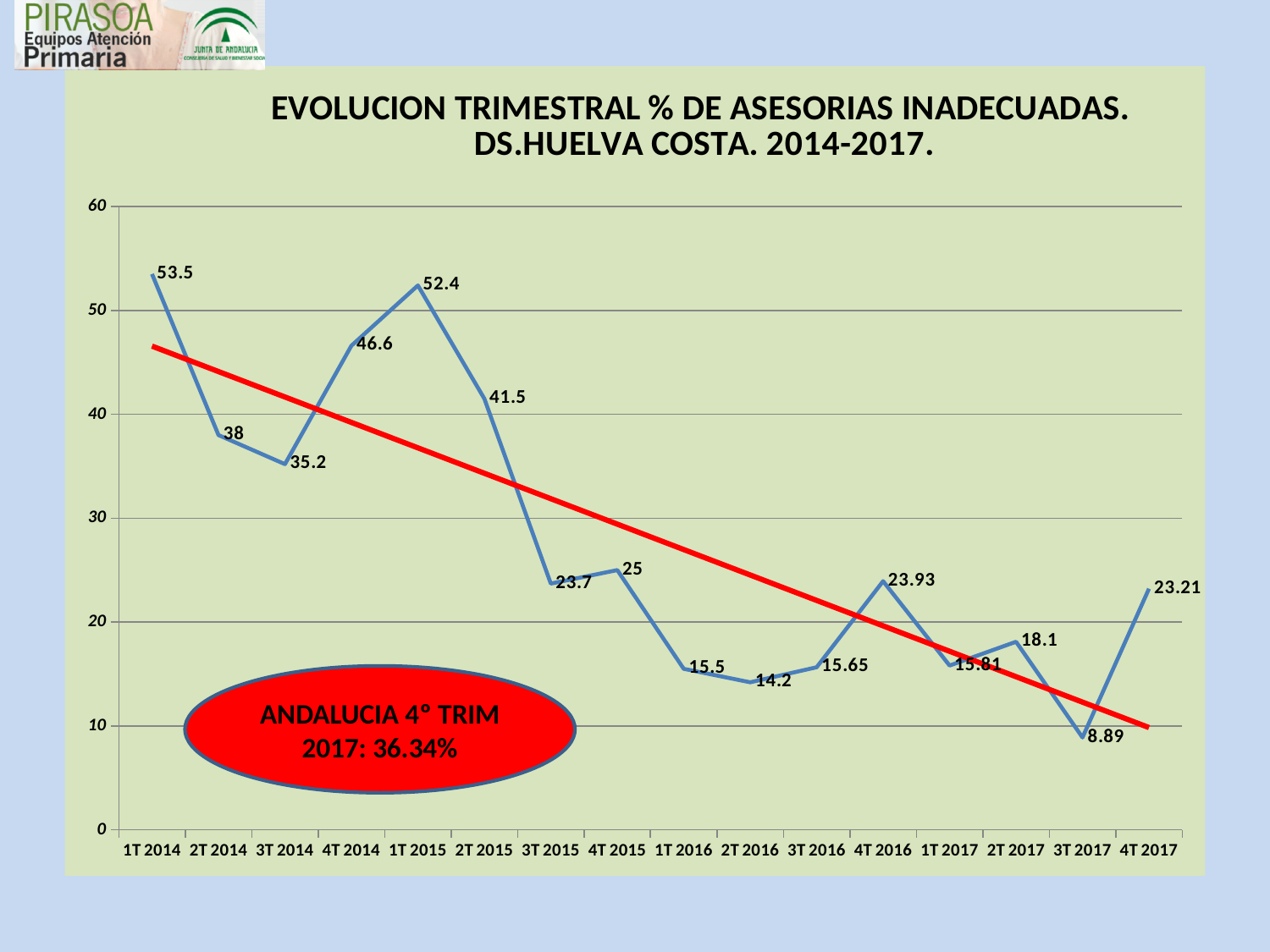
What is the difference between the values for 1T 2015 and 2T 2015? 10.9 What kind of chart is shown on the slide? line chart Which quarter has the lowest value? 3T 2017 Do the values generally rise or fall from 1T 2014 to 4T 2017? fall What is the value for 3T 2017? 8.89 Which is larger, the value for 4T 2016 or the value for 4T 2017? 4T 2016 How many quarters are plotted on the x axis? 16 What is the value for 2T 2016? 14.2 Which quarter has the highest value? 1T 2014 What is the value for 4T 2017? 23.21 What is the value for 1T 2014? 53.5 Is the value for 3T 2015 greater or less than 30? less